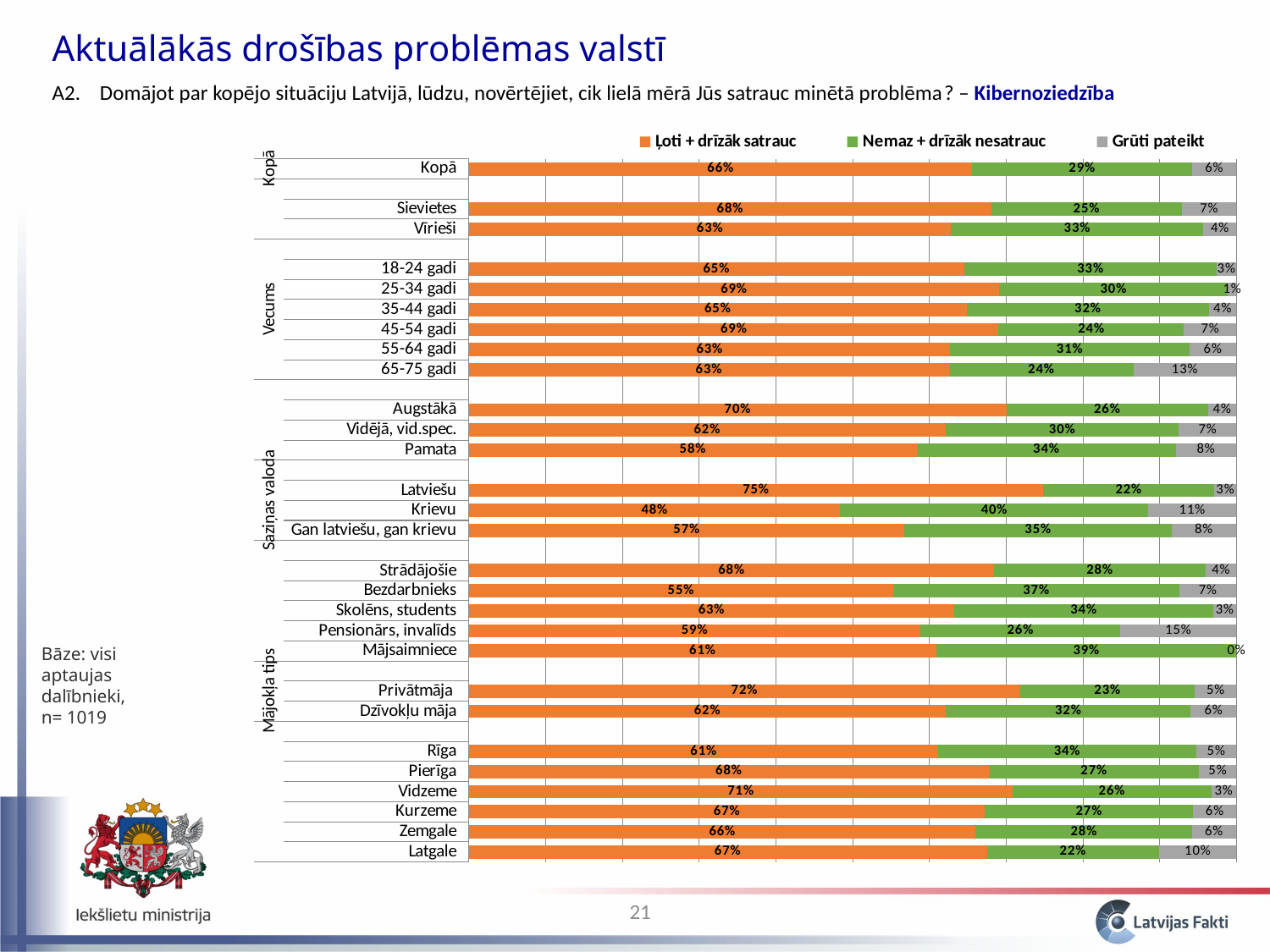
Which colour represents the "Grūti pateikt" series? grey How many series does the legend list? 3 What is the difference between the "Ļoti + drīzāk satrauc" values for Sievietes and Vīrieši? 5% What is the total of the stacked bar for 65-75 gadi? 100% Which category has the lowest value for "Ļoti + drīzāk satrauc"? Krievu How many categories are plotted in the chart? 28 What is the value of "Grūti pateikt" for Pensionārs, invalīds? 15% Which category has the highest value for "Ļoti + drīzāk satrauc"? Latviešu What is the value of "Nemaz + drīzāk nesatrauc" for Krievu? 40% What kind of chart is shown on the slide? bar chart What is the value of "Ļoti + drīzāk satrauc" for Kopā? 66% Which has a larger "Ļoti + drīzāk satrauc" value, Privātmāja or Dzīvokļu māja? Privātmāja